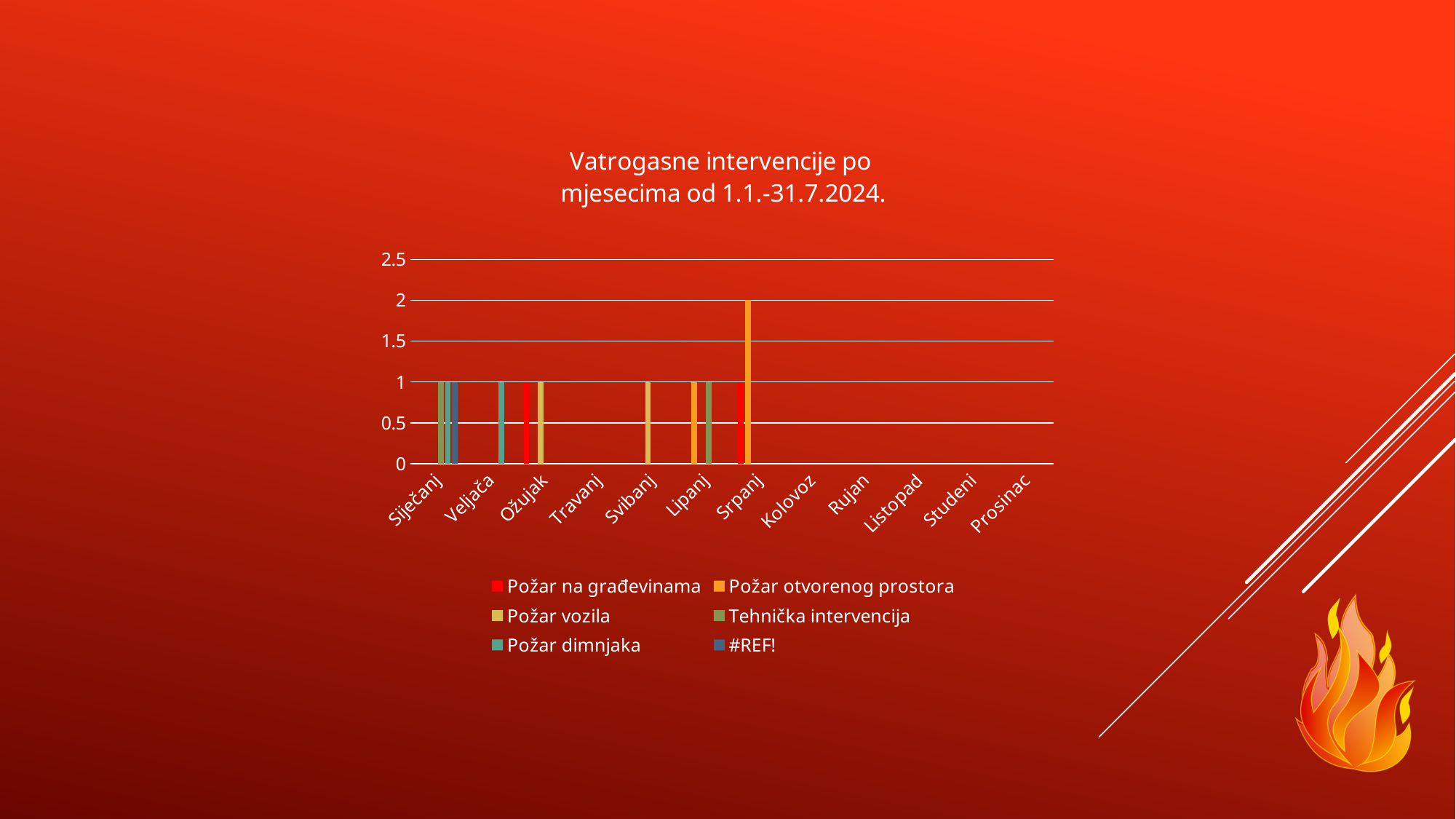
Which legend entry is shown in red? Požar na građevinama What is the title of the chart? Vatrogasne intervencije po mjesecima od 1.1.-31.7.2024. Which month has the tallest bar in the chart? Srpanj What is the difference between Požar otvorenog prostora in Srpanj and Požar na građevinama in Srpanj? 1 How many series does the legend list? 6 What kind of chart is shown on the slide? bar chart How many months (categories) are shown on the x axis? 12 Which is larger: Požar otvorenog prostora in Srpanj or Požar otvorenog prostora in Lipanj? Požar otvorenog prostora in Srpanj What is the value of Požar otvorenog prostora in Srpanj? 2 Is the value of Požar otvorenog prostora in Srpanj greater or less than 1.5? greater What is the value of Požar dimnjaka in Veljača? 1 What is the value of Požar vozila in Svibanj? 1